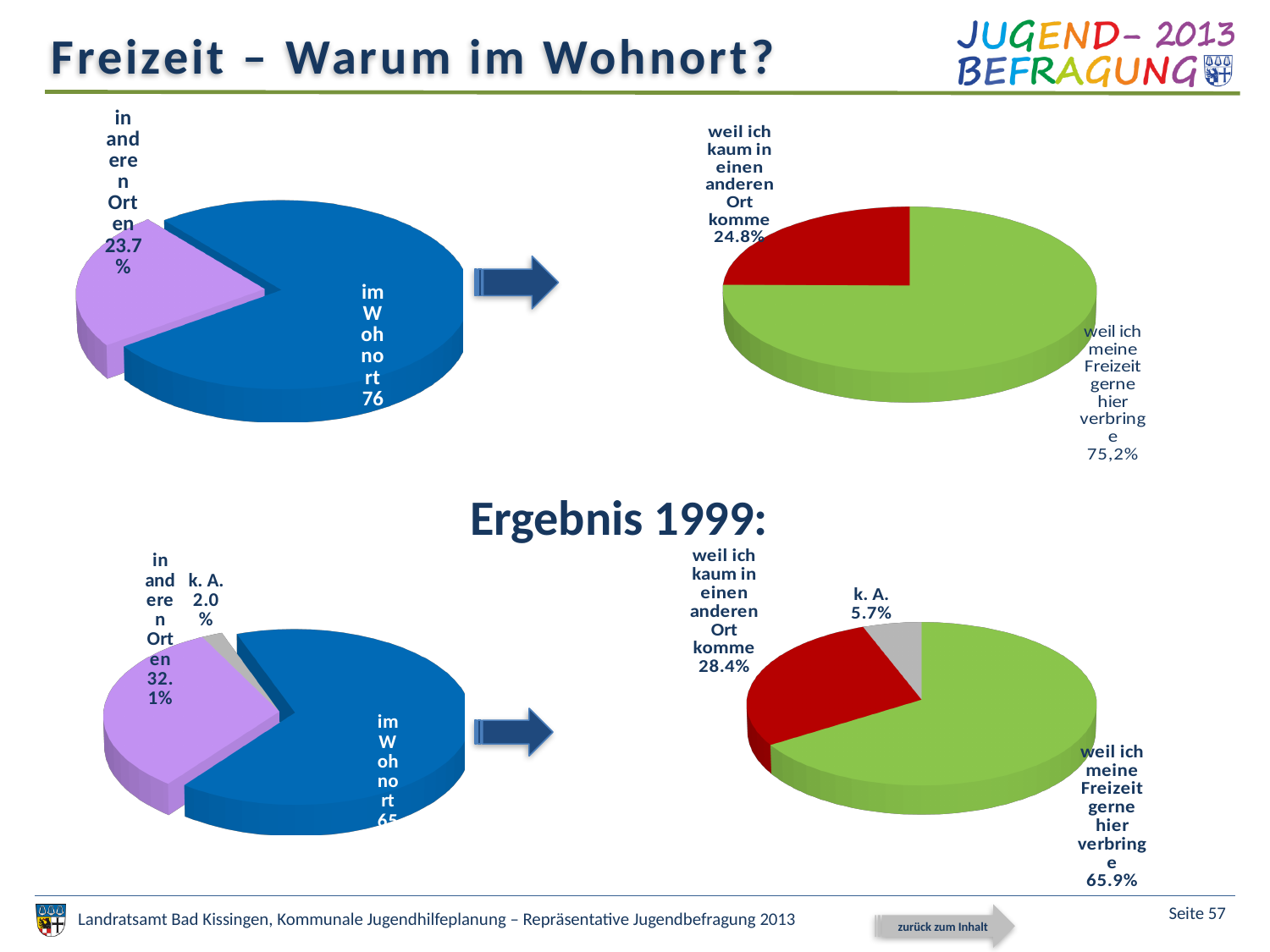
In the bottom-left pie chart (Ergebnis 1999), what share is labelled for "k. A."? 2.0% In the bottom-right pie chart (Ergebnis 1999), which category has the smallest slice? k. A. In the bottom-right pie chart (Ergebnis 1999), which category has the largest slice? weil ich meine Freizeit gerne hier verbringe In the bottom-left pie chart (Ergebnis 1999), what share is labelled for "in anderen Orten"? 32.1% In the top-left pie chart, what share is labelled for "in anderen Orten"? 23.7% What kind of chart is the top-left chart on the slide? Pie chart In the top-right pie chart, what share is labelled for "weil ich meine Freizeit gerne hier verbringe"? 75,2% How many slices does the bottom-right pie chart (Ergebnis 1999) have? 3 In the bottom-right pie chart (Ergebnis 1999), what share is labelled for "weil ich meine Freizeit gerne hier verbringe"? 65.9% In the top-right pie chart, what share is labelled for "weil ich kaum in einen anderen Ort komme"? 24.8% In the bottom-right pie chart (Ergebnis 1999), what share is labelled for "k. A."? 5.7% In the bottom-right pie chart (Ergebnis 1999), what share is labelled for "weil ich kaum in einen anderen Ort komme"? 28.4%